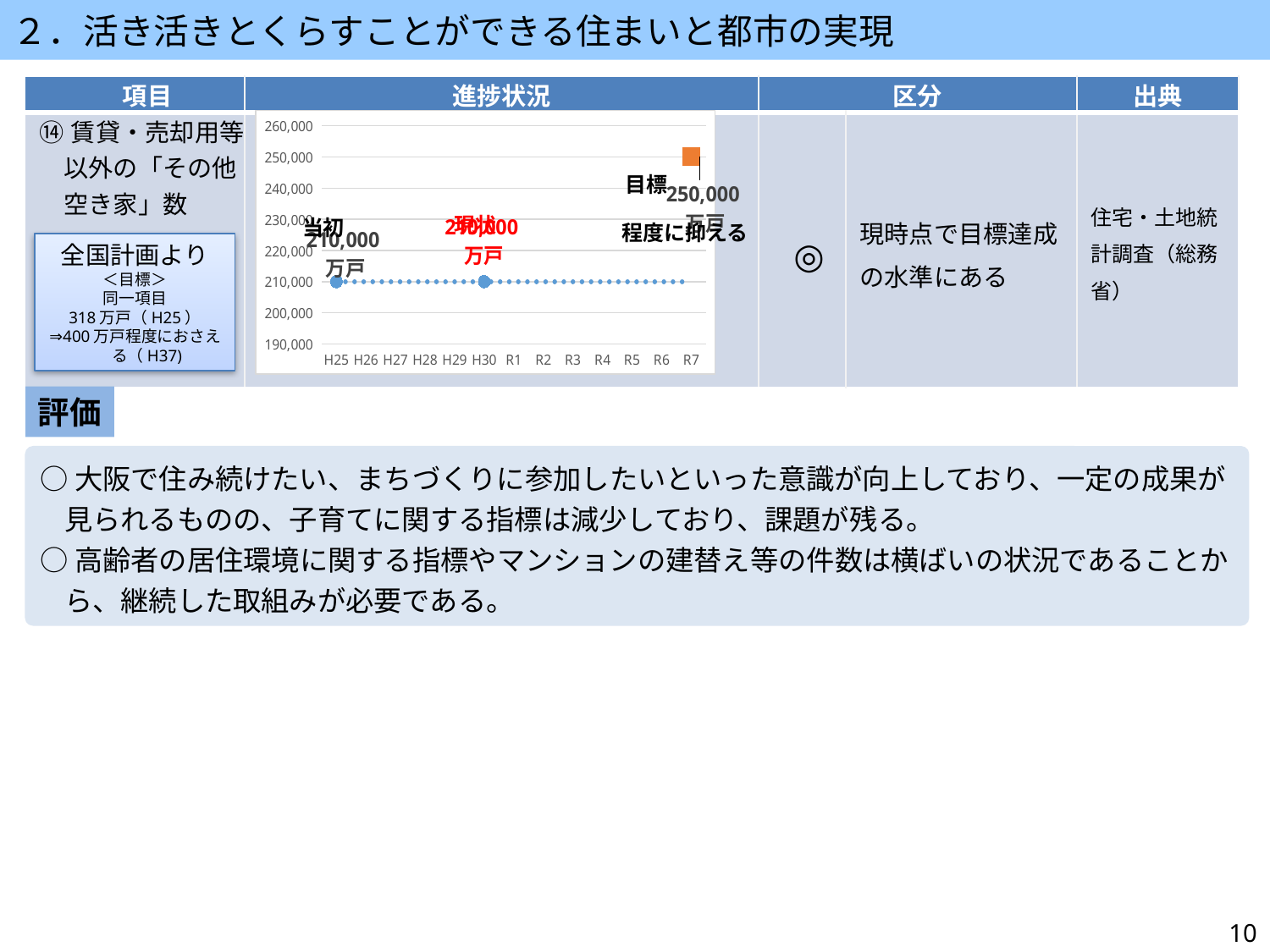
What kind of chart is shown in the 進捗状況 column? line chart Is the 目標 point at R7 greater or less than 240,000? greater How many categories are shown on the x axis of the chart? 13 What is the difference between the 目標 value and the 当初 value on the chart? 40,000 Does the blue dotted line rise, fall, or stay flat from H25 to R7? stays flat What colour is the marker for the 目標 point on the chart? orange What is the highest tick value shown on the y axis of the chart? 260,000 What is the first label on the x axis of the chart? H25 Which is larger on the chart, the 当初 value or the 目標 value? 目標 What value is labelled for 目標 on the chart? 250,000万戸 What value is labelled for 当初 on the chart? 210,000万戸 Is the value plotted at H25 greater or less than 220,000? less